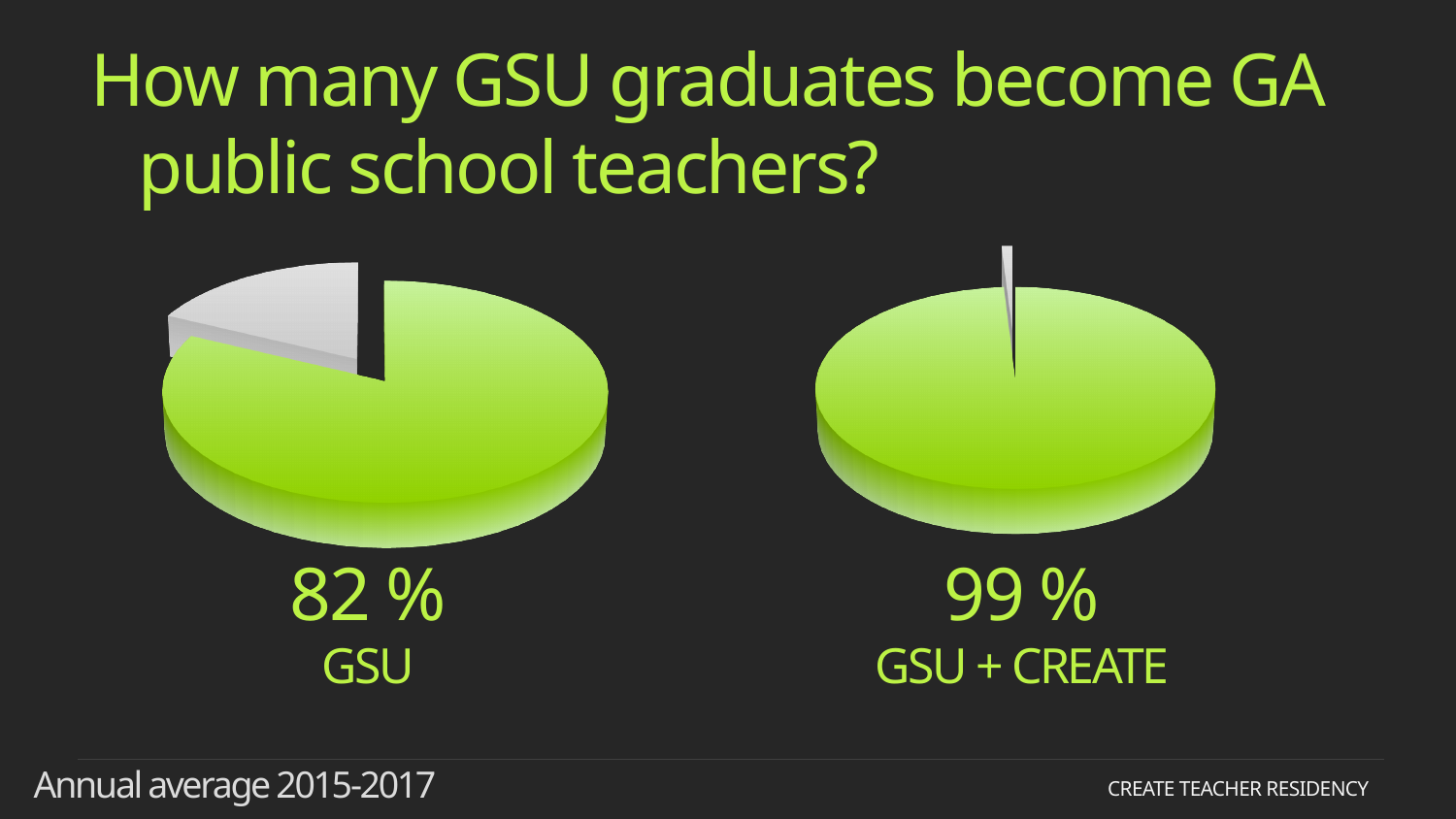
What percentage is shown for the right pie chart labelled GSU + CREATE? 99 % What percentage is shown for the left pie chart labelled GSU? 82 % What is the difference in percentage points between the GSU + CREATE pie chart and the GSU pie chart? 17 What is the label under the left pie chart? GSU What time period do the pie charts cover, according to the note at the bottom of the slide? Annual average 2015-2017 In the left pie chart (GSU), is the green slice greater or less than 50% of the pie? greater Which of the two pie charts shows the higher percentage, GSU or GSU + CREATE? GSU + CREATE In the left pie chart (GSU), which slice is larger, the green slice or the grey slice? The green slice What kind of charts are shown on the slide? Pie charts How many pie charts are on the slide? 2 In the right pie chart (GSU + CREATE), is the grey slice greater or less than 10% of the pie? less Which of the two pie charts shows the lower percentage, GSU or GSU + CREATE? GSU